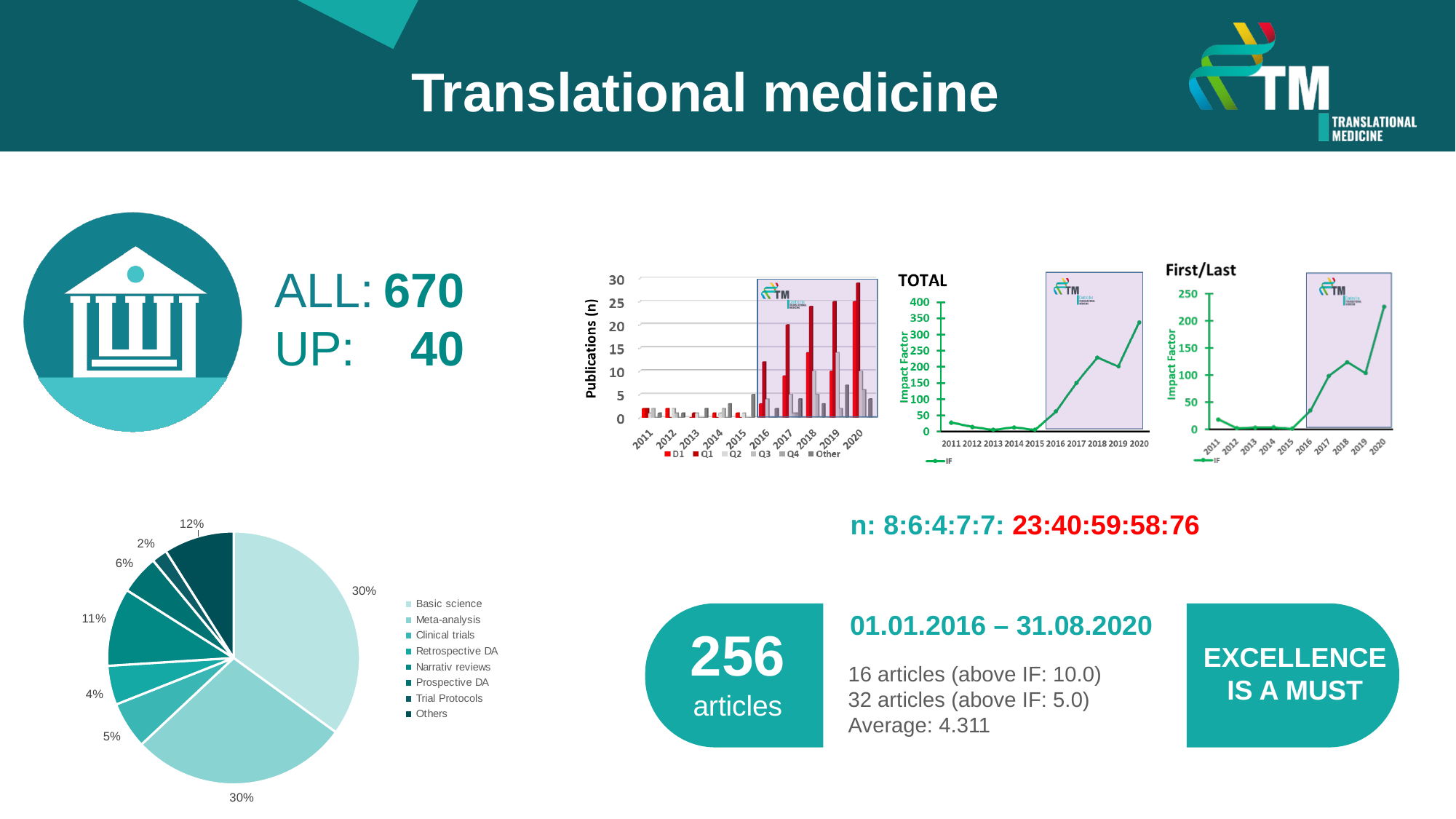
In the pie chart, what is the difference between the Narrativ reviews share and the Prospective DA share? 5% What kind of chart is the TOTAL Impact Factor chart? line chart In the pie chart, what share of the pie is Basic science? 30% In the Publications (n) bar chart, how many series does the legend list? 6 In the Publications (n) bar chart, is the Q1 value for 2020 greater or less than 25? greater In the Publications (n) bar chart, how many years are shown on the x axis? 10 In the pie chart, what share of the pie is Others? 12% In the pie chart, what share of the pie is Narrativ reviews? 11% In the pie chart, which is larger, the Clinical trials slice or the Retrospective DA slice? Clinical trials In the pie chart, how many categories does the legend list? 8 In the First/Last Impact Factor chart, is the value for 2020 greater or less than 200? greater In the pie chart, which category has the smallest slice? Trial Protocols